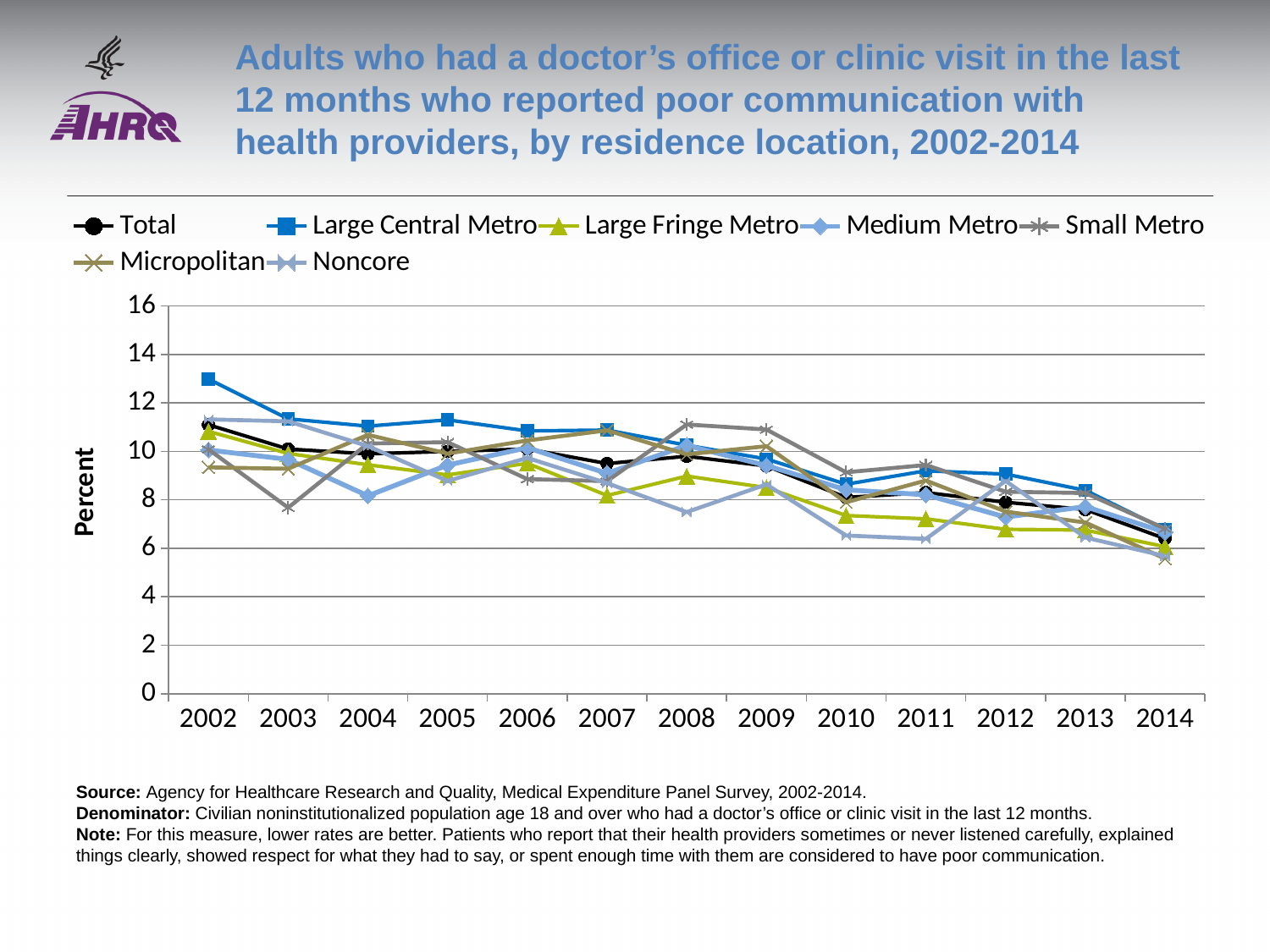
Does the Total series generally rise or fall from 2002 to 2014? Fall Is the value for Large Central Metro in 2002 greater or less than 12? greater How many years are shown along the x axis? 13 Is the value for Total in 2002 greater or less than 10? greater Which is larger in 2002, the value for Large Central Metro or the value for Total? Large Central Metro How many series does the legend list? 7 Is the value for Medium Metro in 2004 greater or less than 10? less Which series has the highest value in 2002? Large Central Metro What is the label on the y axis? Percent What kind of chart is shown on the slide? Line chart